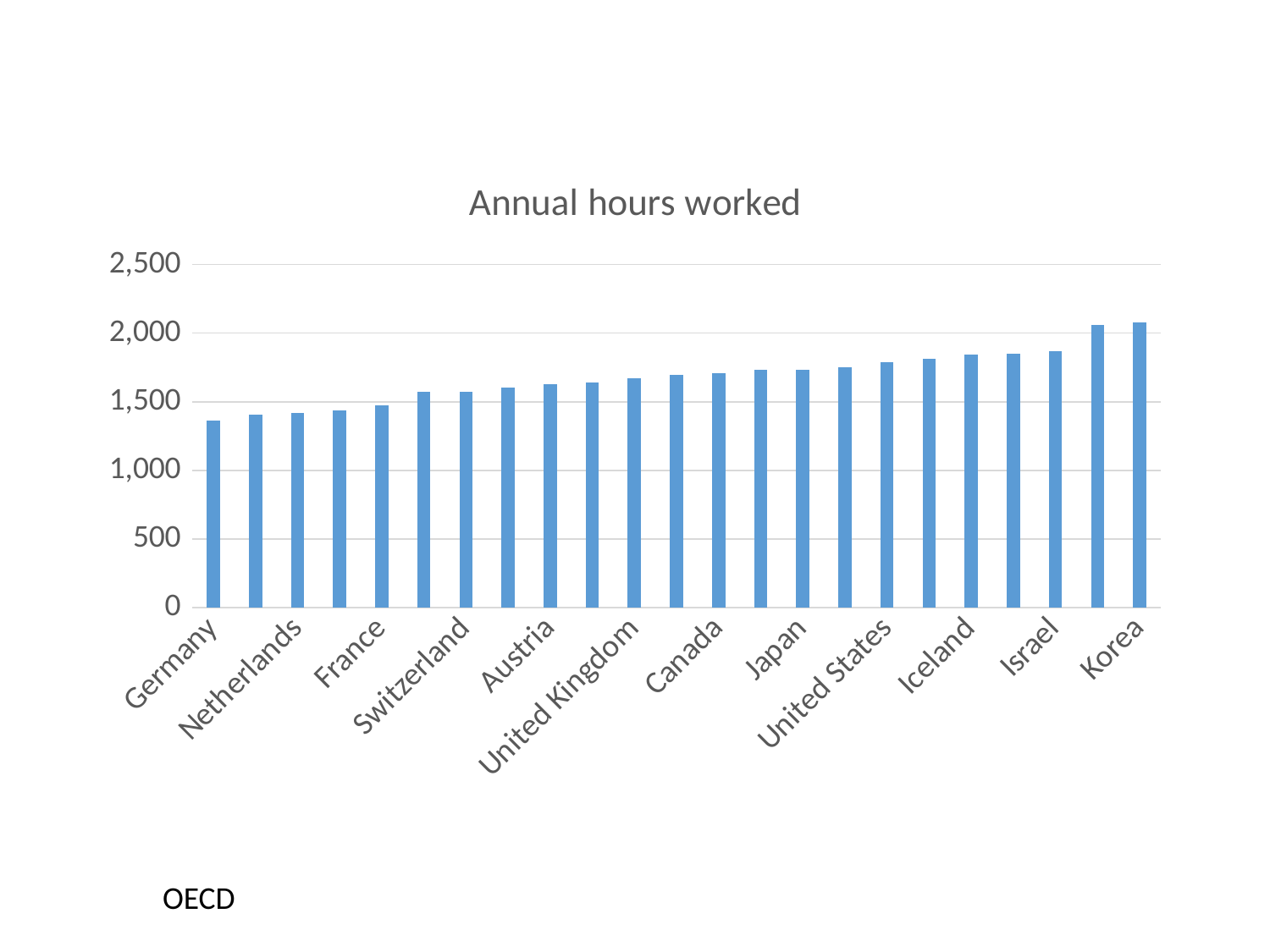
Is the value for Israel greater or less than 2,000? less Which labelled country has the lowest annual hours worked? Germany Which labelled country has the highest annual hours worked? Korea Do the values rise or fall from left to right along the x axis? rise Is the value for Japan greater or less than 1,500? greater Which has more annual hours worked, Israel or France? Israel What kind of chart is shown on the slide? bar chart What is the title of the chart? Annual hours worked Is the value for Korea greater or less than 2,000? greater What source is cited at the bottom of the slide? OECD